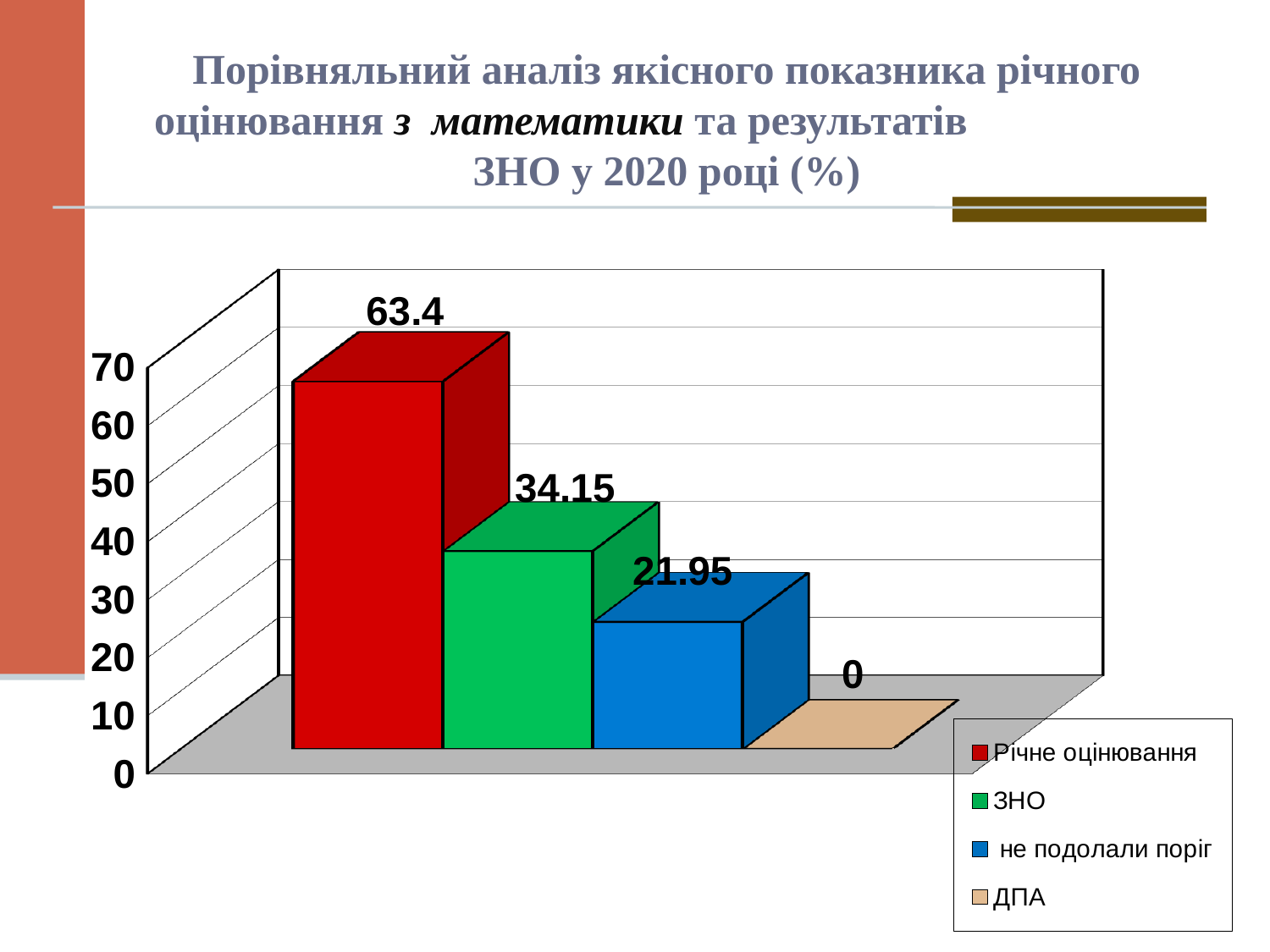
How many series does the legend list? 4 What is the value for ЗНО? 34.15 Which series has the highest value? Річне оцінювання What is the value for не подолали поріг? 21.95 What is the difference between the values for ЗНО and не подолали поріг? 12.2 What colour is the bar for ЗНО? green What is the difference between the values for Річне оцінювання and ЗНО? 29.25 What is the value for Річне оцінювання? 63.4 Which series has the lowest value? ДПА Which is larger, the value for ЗНО or the value for не подолали поріг? ЗНО What is the value for ДПА? 0 What kind of chart is shown on the slide? bar chart